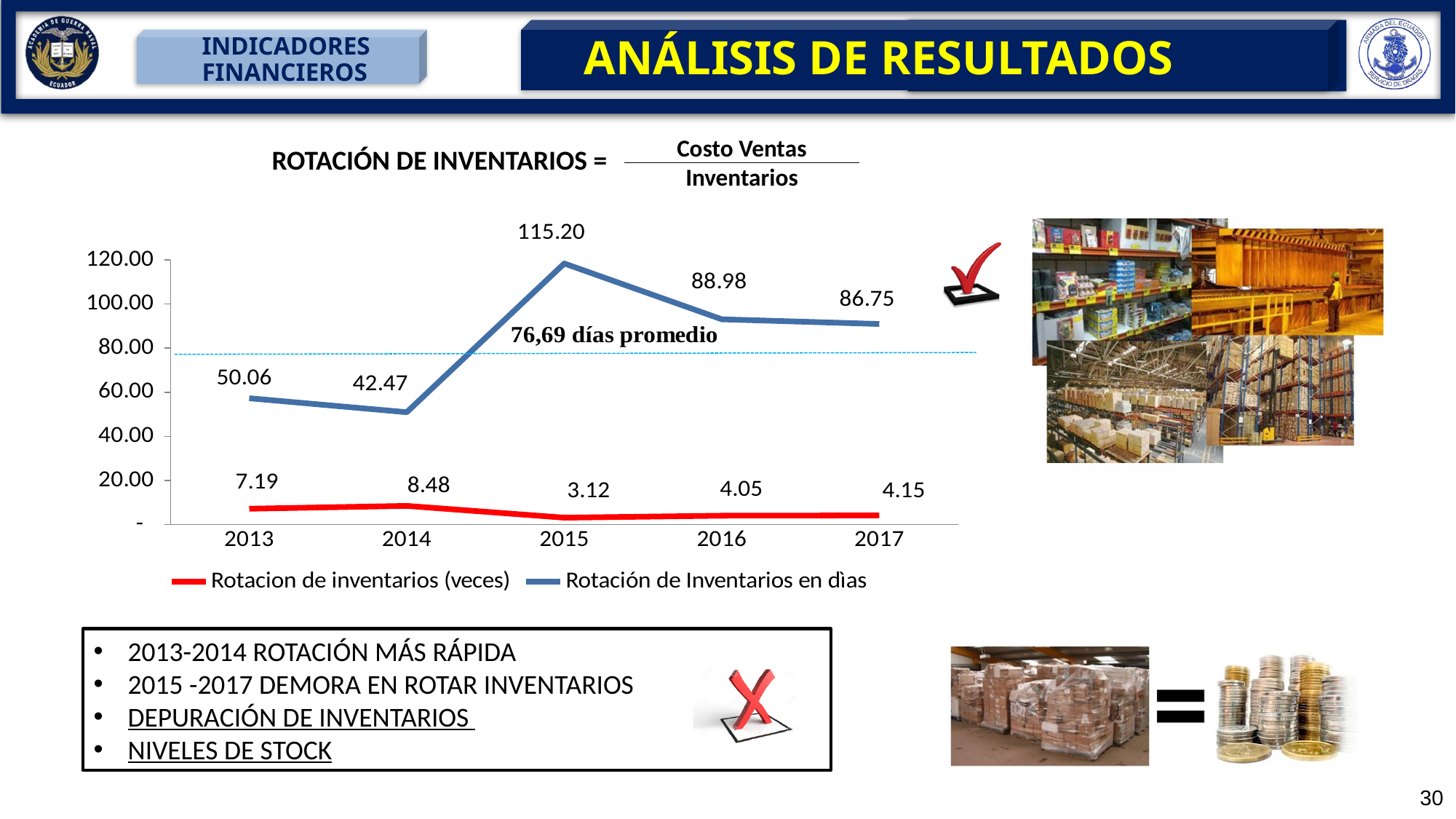
What is the value of Rotacion de inventarios (veces) for 2014? 8.48 In which year is Rotación de Inventarios en dìas highest? 2015 What type of chart is shown on the slide? Line chart What is the value of Rotación de Inventarios en dìas for 2015? 115.20 What is the value of Rotación de Inventarios en dìas for 2017? 86.75 How many years are plotted along the x axis of the chart? 5 In which year is Rotacion de inventarios (veces) lowest? 2015 Which is larger, Rotacion de inventarios (veces) in 2013 or in 2016? 2013 What is the difference between Rotación de Inventarios en dìas in 2015 and 2014? 72.73 Does Rotación de Inventarios en dìas rise or fall from 2015 to 2017? Fall How many series does the chart legend list? 2 What average value in days is marked by the dashed line on the chart? 76,69 días promedio